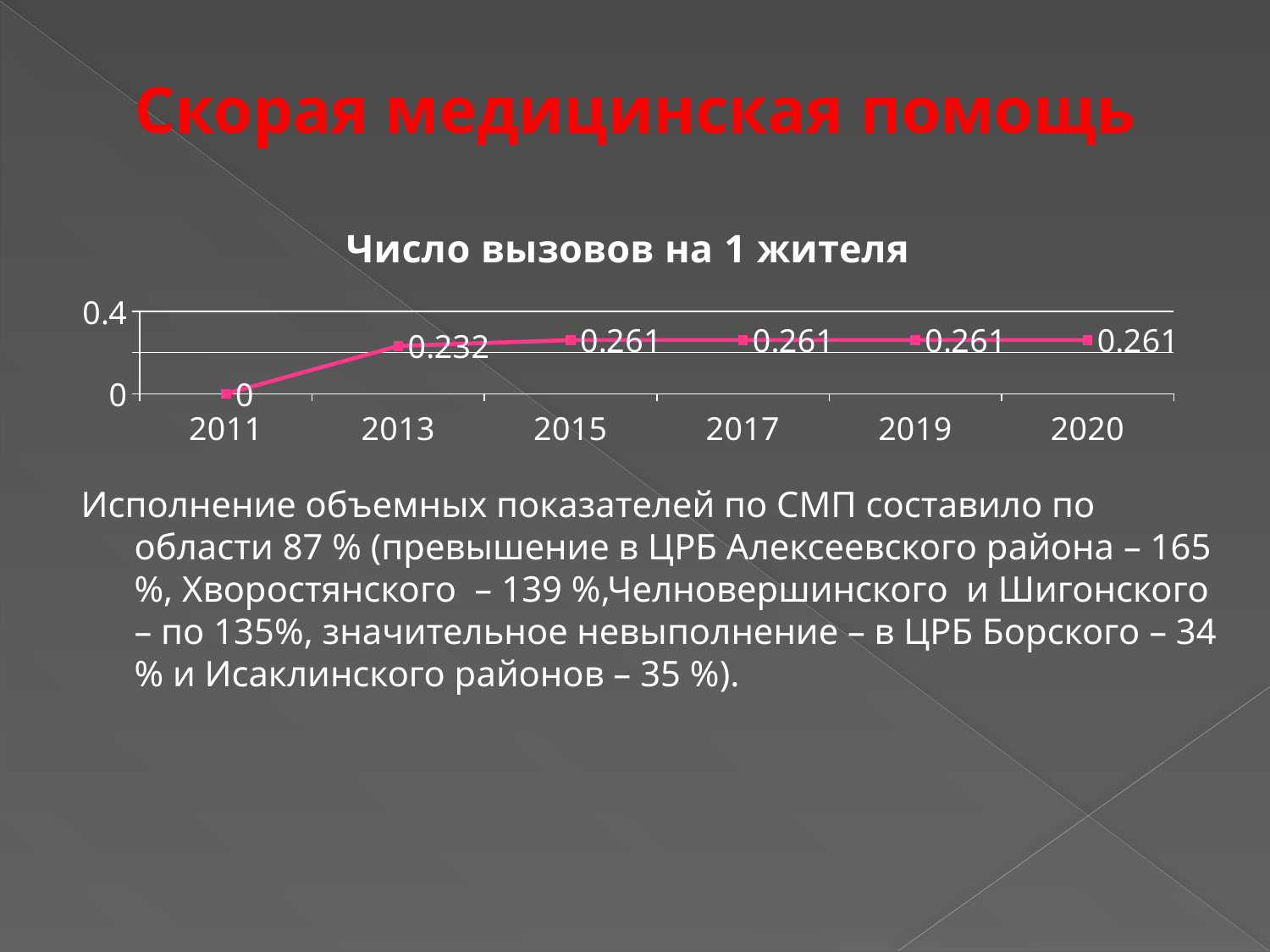
Does the value rise or fall from 2011 to 2015? rise What type of chart is shown on the slide? line chart What is the title of the chart? Число вызовов на 1 жителя What is the difference between the values for 2015 and 2013? 0.029 What is the value for 2017? 0.261 Which year has the lowest value? 2011 Is the value for 2019 greater or less than 0.4? less What is the value for 2013? 0.232 What is the value for 2020? 0.261 How many years are plotted on the x axis? 6 What is the value for 2011? 0 Which is larger, the value for 2013 or the value for 2017? 2017